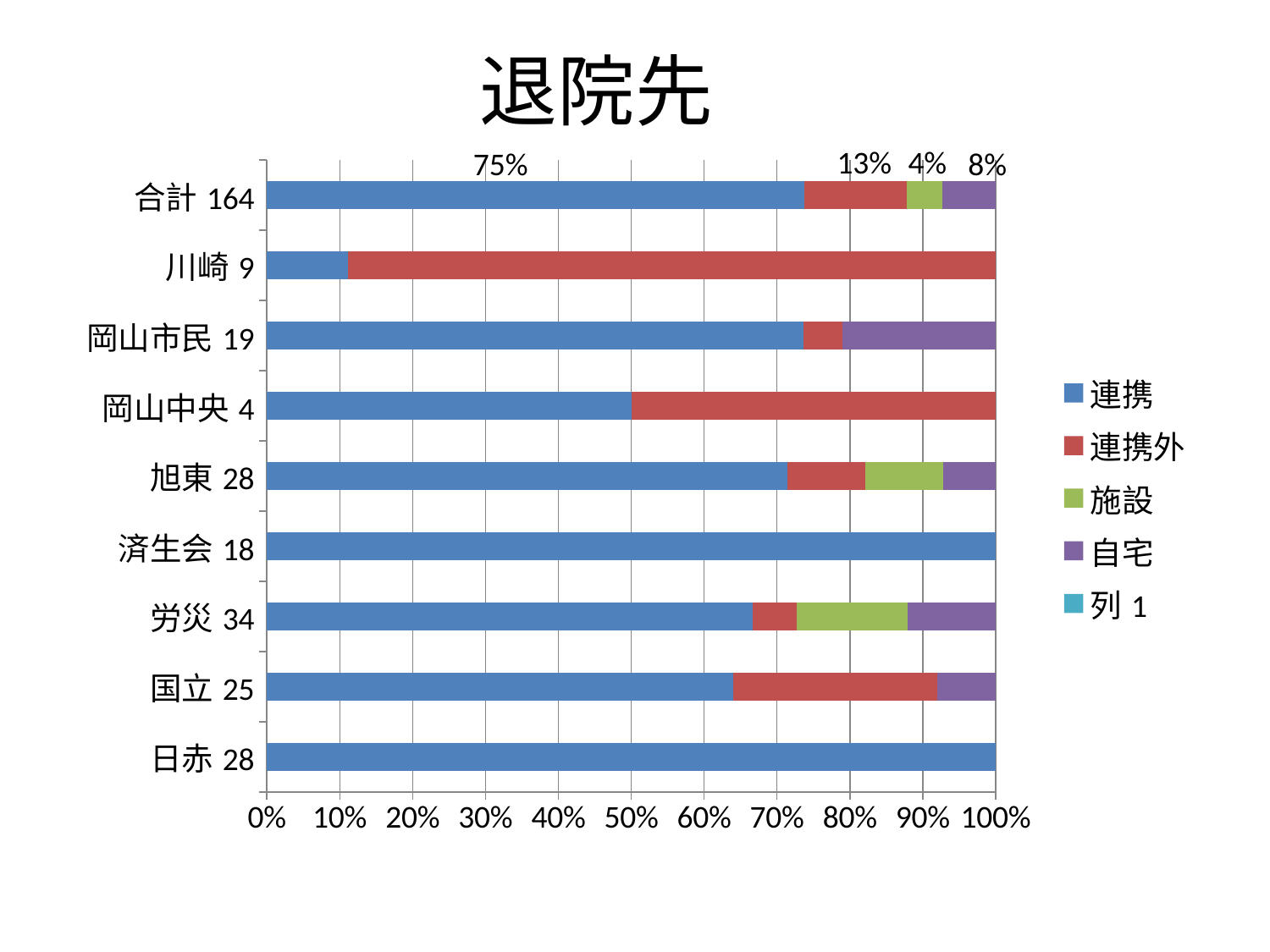
How many categories (bars) are shown on the y axis? 9 What is the difference between the 連携 share and the 連携外 share for 合計 164? 62% What is the 連携外 share for 合計 164? 13% What is the 自宅 share for 合計 164? 8% What is the 施設 share for 合計 164? 4% What is the title of the chart? 退院先 How many series does the legend list? 5 Is the 連携 share for 労災 34 greater or less than 60%? greater What is the 連携 share for 合計 164? 75% Is the 連携 share for 川崎 9 greater or less than 20%? less Which has the larger 連携 share, 済生会 18 or 川崎 9? 済生会 18 What kind of chart is shown on the slide? stacked bar chart